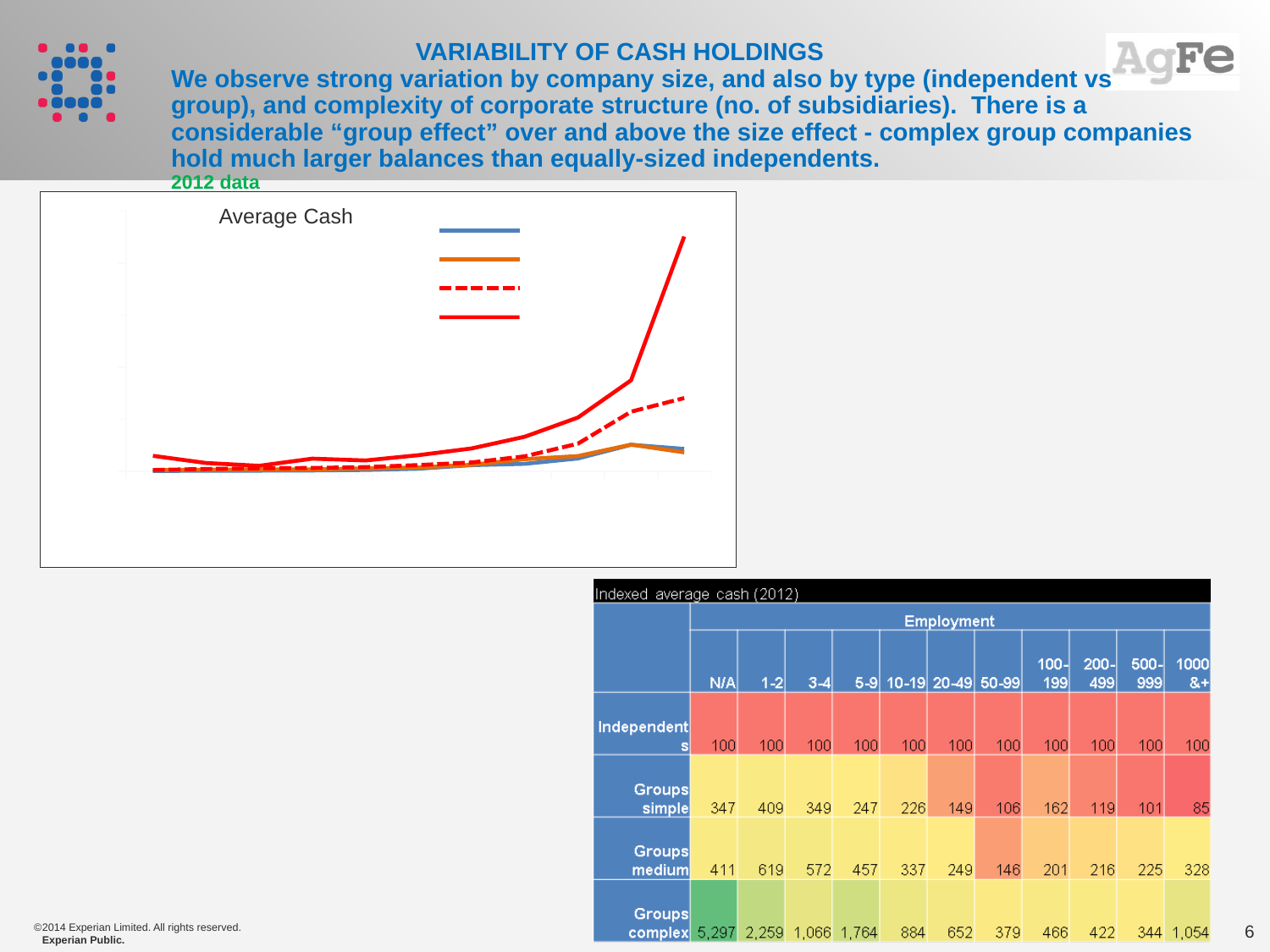
What kind of chart is the "Average Cash" chart? line chart How many series does the legend of the "Average Cash" chart list? 4 What is the title of the line chart on the slide? Average Cash In the "Average Cash" chart, which line style is used for the series that ends second highest at the right-hand end? the dashed red line In the "Average Cash" chart, which line reaches the highest value at the right-hand end of the x axis? the solid red line In the "Average Cash" chart, do the values of the solid red line rise or fall moving from left to right along the x axis? rise